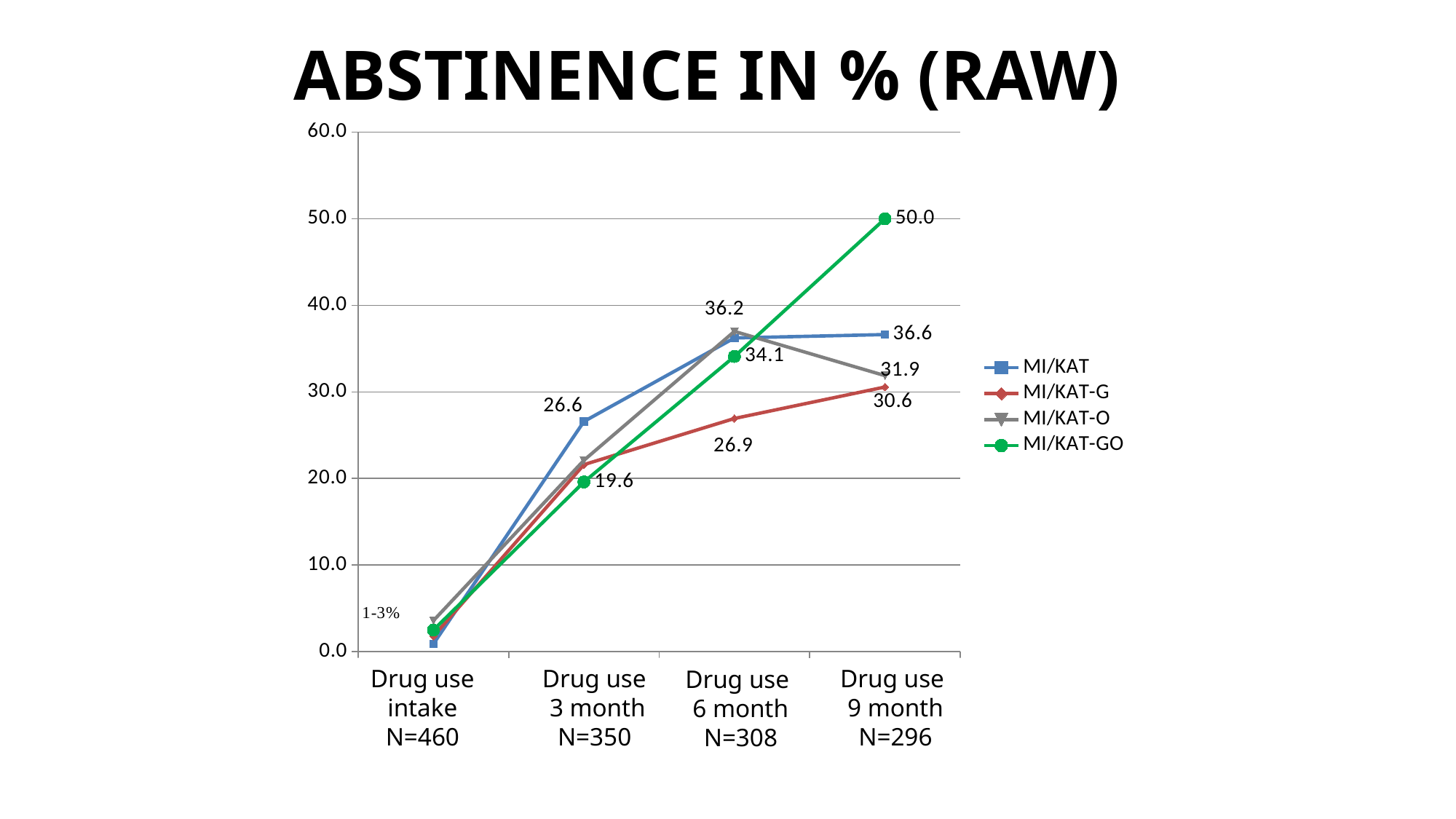
What is the value for MI/KAT-G at Drug use 6 month N=308? 26.9 What is the value for MI/KAT-GO at Drug use 9 month N=296? 50.0 What is the difference between the MI/KAT-GO values at Drug use 9 month N=296 and Drug use 6 month N=308? 15.9 Which series has the lowest value at Drug use 9 month N=296? MI/KAT-G What is the value for MI/KAT-O at Drug use 9 month N=296? 31.9 Which series has the highest value at Drug use 9 month N=296? MI/KAT-GO How many series does the legend list? 4 What kind of chart is shown on the slide? line chart What is the value for MI/KAT at Drug use 3 month N=350? 26.6 At Drug use 3 month N=350, which is larger: MI/KAT or MI/KAT-GO? MI/KAT Is the value for MI/KAT at Drug use 6 month N=308 greater or less than 30.0? greater How many categories are shown on the x axis? 4